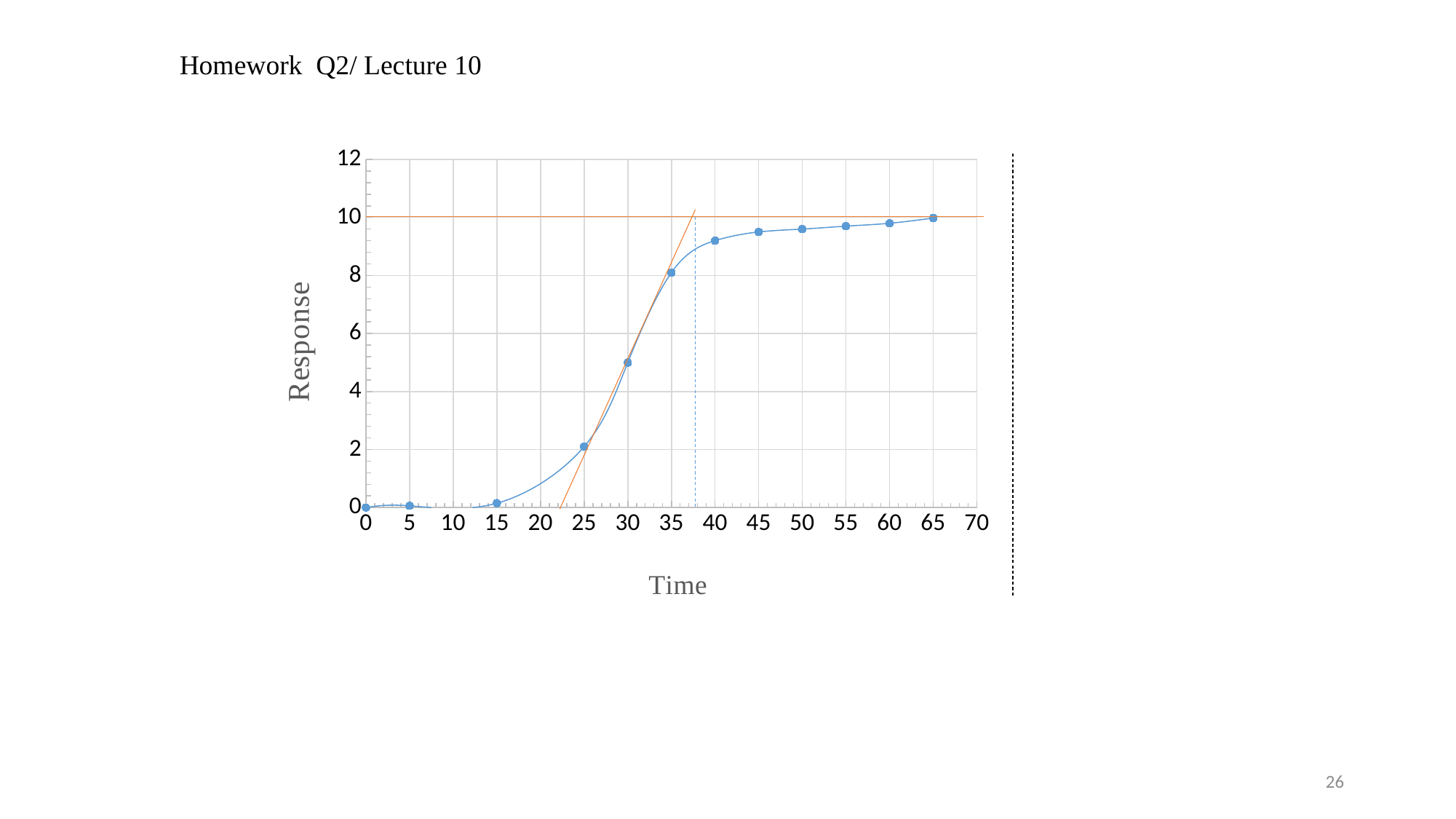
What kind of chart is shown on the slide? line chart How many data points are plotted on the curve? 12 Is the response at time 35 greater or less than 6? greater Does the response rise or fall as time increases along the x axis? rise Is the response at time 40 greater or less than 8? greater What is the label of the x axis? Time What is the response value at time 0? 0 Which has the larger response, time 30 or time 45? time 45 Is the response at time 25 greater or less than 4? less What is the label of the y axis? Response Which has the larger response, time 25 or time 35? time 35